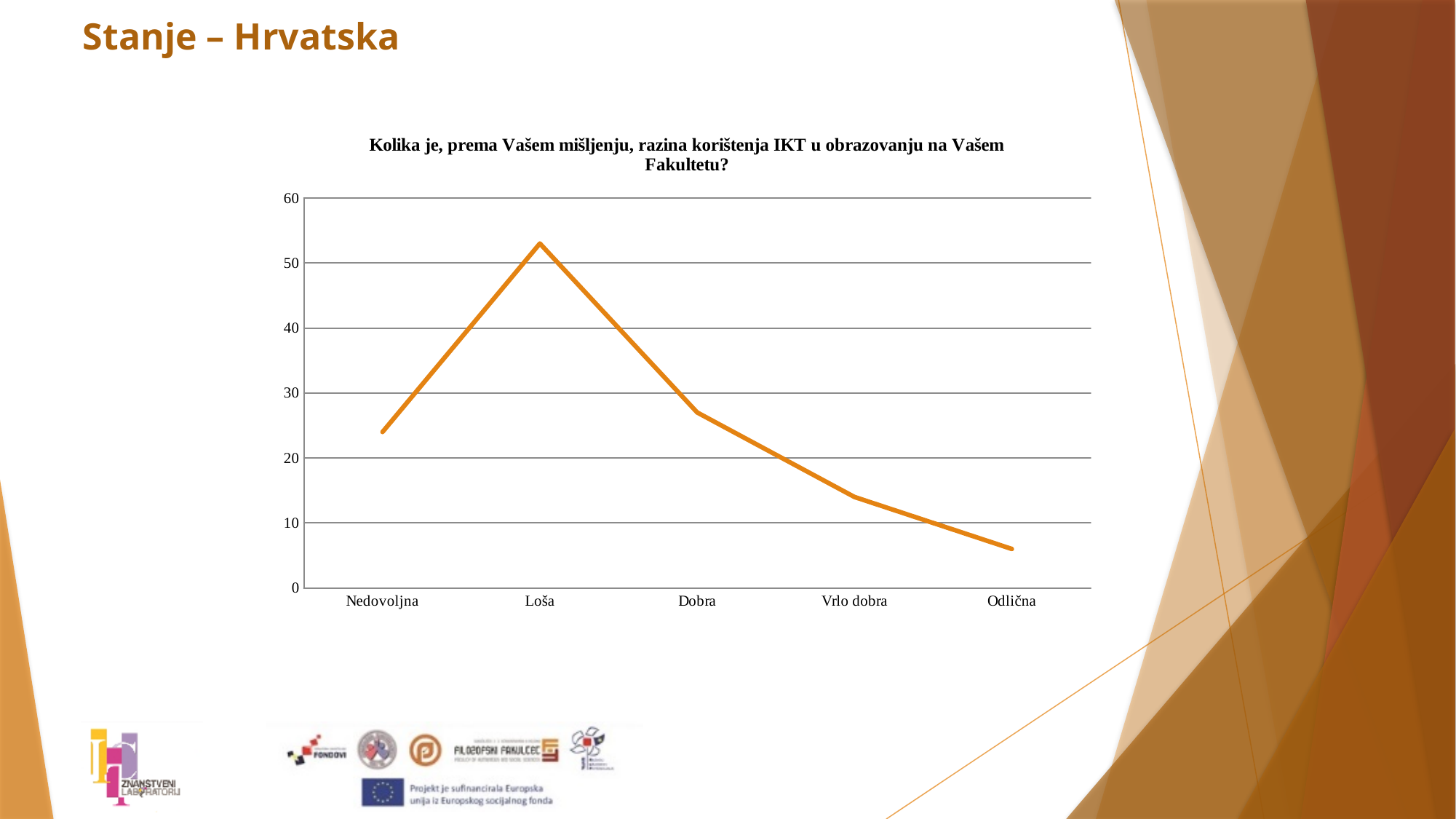
Do the values rise or fall along the x axis from Loša to Odlična? fall Which category has the lowest value in the chart? Odlična How many categories are shown on the x axis of the chart? 5 What is the title of the chart? Kolika je, prema Vašem mišljenju, razina korištenja IKT u obrazovanju na Vašem Fakultetu? Is the value for Odlična greater or less than 10? less Is the value for Vrlo dobra greater or less than 10? greater Is the value for Dobra greater or less than 30? less What kind of chart is shown on the slide? line chart Which category has the highest value in the chart? Loša Which is larger, the value for Loša or the value for Dobra? Loša